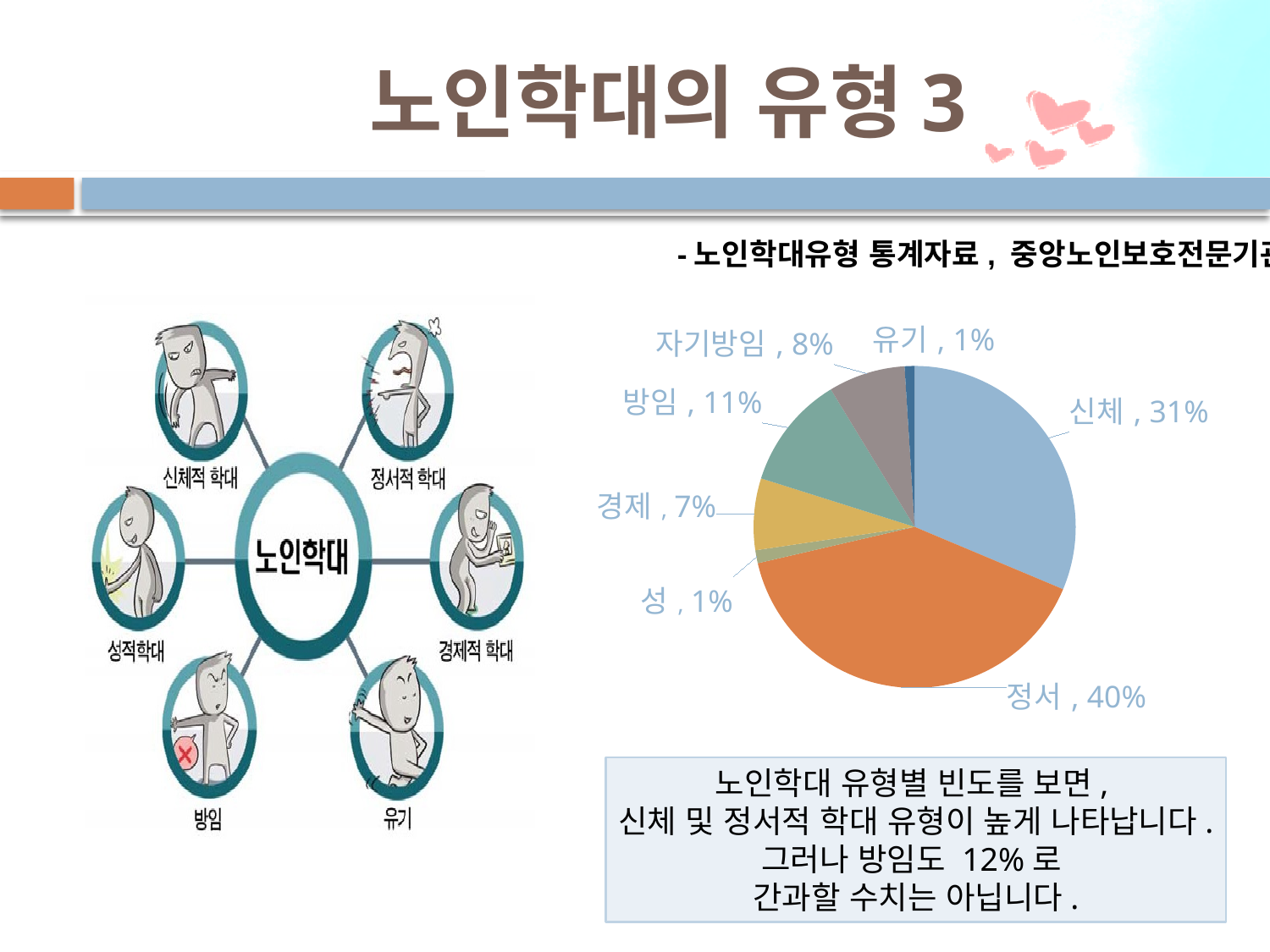
What percentage does the 방임 slice of the pie chart represent? 11% What percentage does the 신체 slice of the pie chart represent? 31% Which slice is larger, 방임 or 경제? 방임 What percentage does the 정서 slice of the pie chart represent? 40% What is the difference in percentage points between the 정서 and 신체 slices? 9 What kind of chart is shown on the slide? pie chart How many slices does the pie chart have? 7 What percentage does the 경제 slice of the pie chart represent? 7% What is the combined share of the 신체 and 정서 slices? 71% Which category has the largest share in the pie chart? 정서 Which two categories each have a share of 1% in the pie chart? 유기 and 성 What percentage does the 자기방임 slice of the pie chart represent? 8%